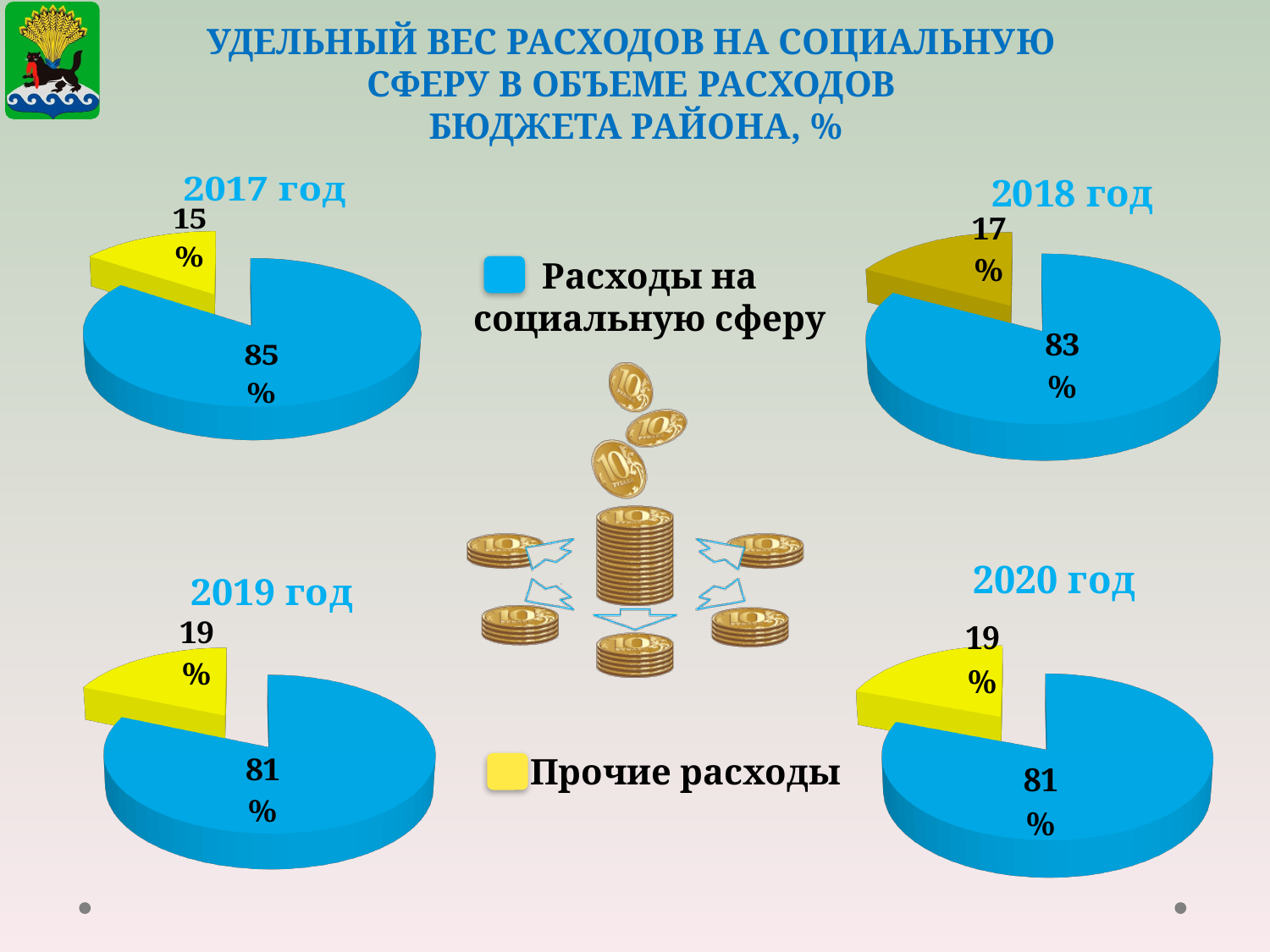
In the 2017 год pie chart, what is the difference between the Расходы на социальную сферу share and the Прочие расходы share? 70% In the 2018 год pie chart, what share is labelled for Расходы на социальную сферу? 83% In the 2017 год pie chart, what share is labelled for Расходы на социальную сферу (blue slice)? 85% Across the four pie charts, in which year is the Прочие расходы share the lowest? 2017 год In the 2020 год pie chart, what share is labelled for Расходы на социальную сферу? 81% In the 2017 год pie chart, what share is labelled for Прочие расходы (yellow slice)? 15% In the 2018 год pie chart, what share is labelled for Прочие расходы? 17% In the 2019 год pie chart, what share is labelled for Прочие расходы? 19% Across the four pie charts, in which year is the Расходы на социальную сферу share the highest? 2017 год What type of chart is used for each year on this slide? Pie chart How many pie charts are shown on the slide? 4 In the 2018 год pie chart, which slice is larger: Расходы на социальную сферу or Прочие расходы? Расходы на социальную сферу